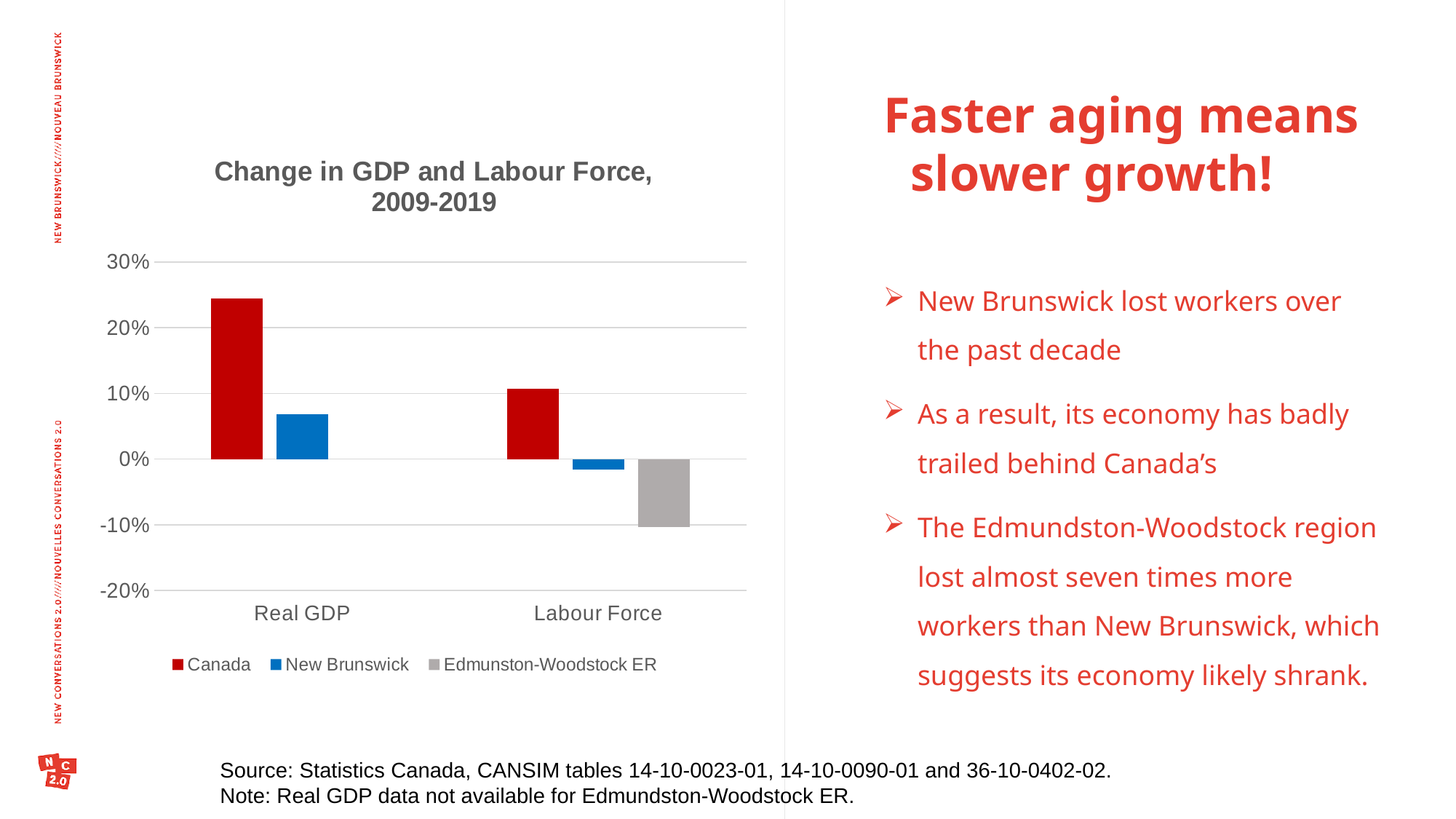
For Labour Force, which is larger: the value for New Brunswick or the value for Edmunston-Woodstock ER? New Brunswick How many categories are shown on the x axis of the chart? 2 Is the Real GDP value for New Brunswick greater or less than 10%? less Is the Labour Force value for Edmunston-Woodstock ER greater or less than 0%? less Is the Real GDP value for Canada greater or less than 20%? greater Which colour represents Canada in the chart legend? Red How many series does the chart legend list? 3 What type of chart is shown on the slide? Bar chart Which series has the highest value for Real GDP? Canada Which series has the lowest value for Labour Force? Edmunston-Woodstock ER What is the title of the chart? Change in GDP and Labour Force, 2009-2019